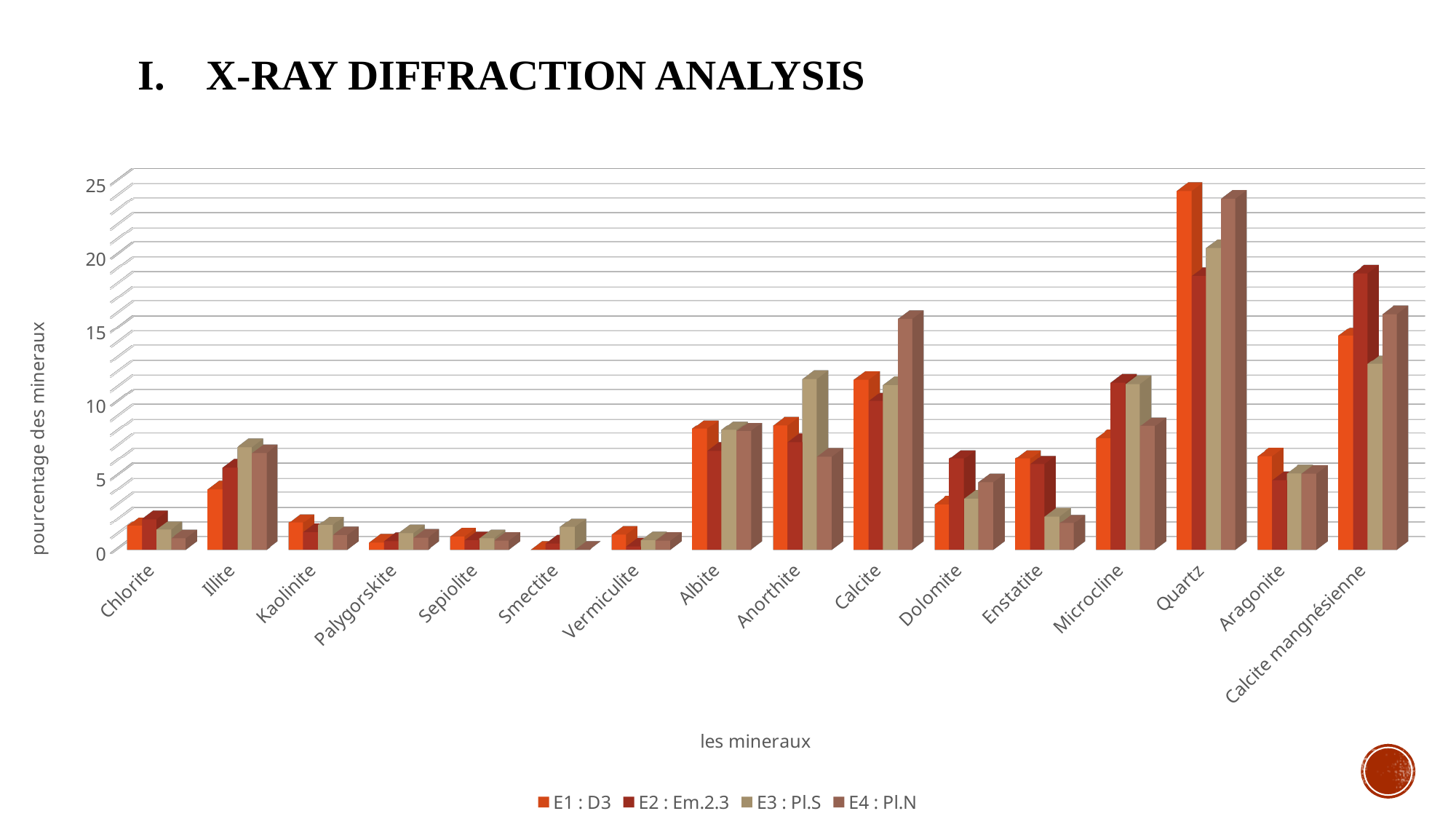
What kind of chart is shown on the slide? bar chart For Calcite mangnésienne, which series has the larger value: E1 : D3 or E2 : Em.2.3? E2 : Em.2.3 Is the value for Dolomite in series E2 : Em.2.3 greater or less than 10? less For Calcite, which series has the larger value: E1 : D3 or E4 : Pl.N? E4 : Pl.N Is the value for Anorthite in series E3 : Pl.S greater or less than 10? greater Is the value for Quartz in series E1 : D3 greater or less than 20? greater How many mineral categories are shown on the x axis? 16 For the series E1 : D3, which mineral has the highest value? Quartz What is the title of the vertical axis? pourcentage des mineraux How many series does the legend list? 4 For the series E1 : D3, which mineral has the lowest value? Smectite For the series E4 : Pl.N, which mineral has the highest value? Quartz